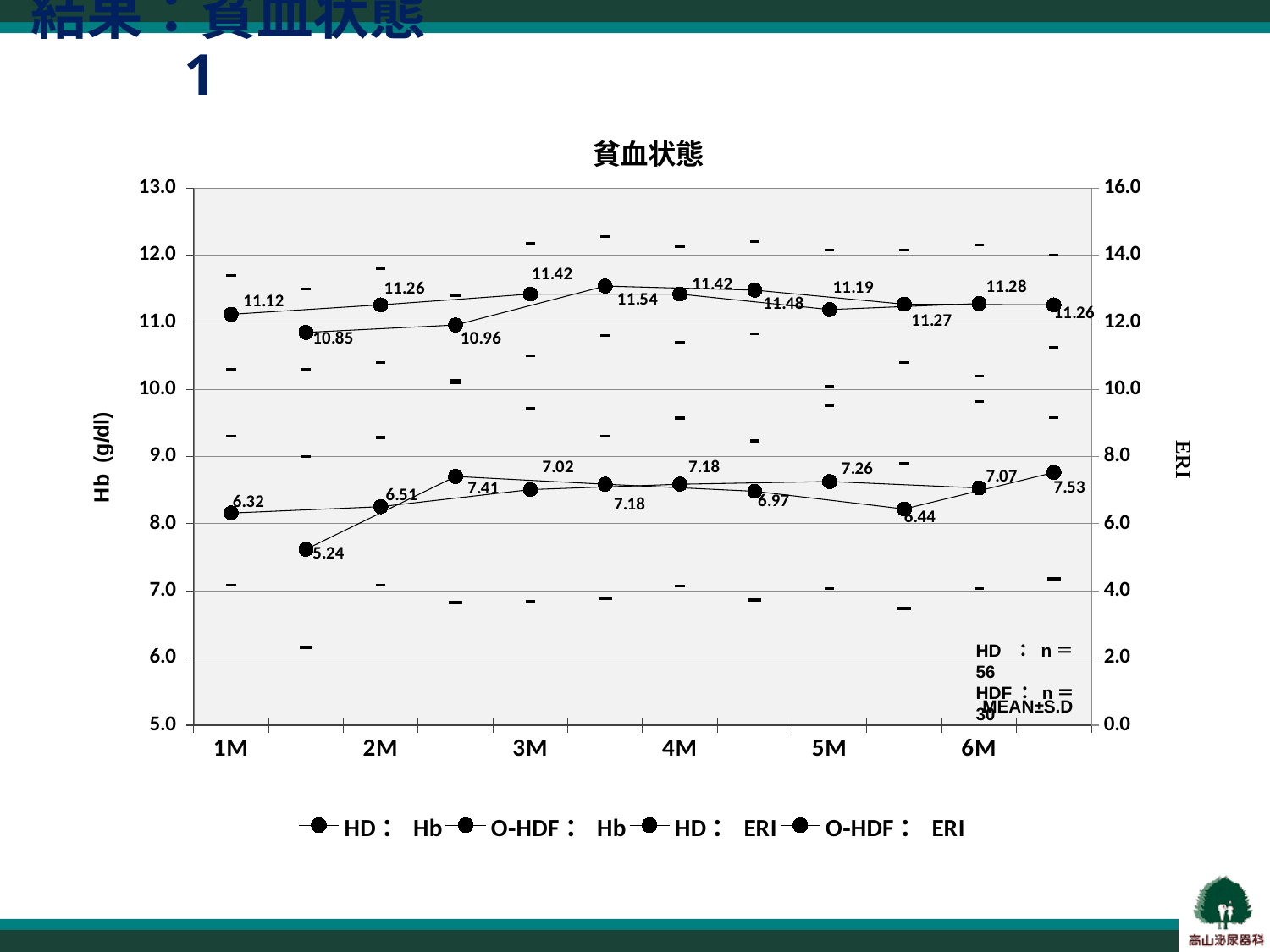
What is the title of the chart? 貧血状態 What is the lowest ERI value labelled on the chart? 5.24 How many month categories are shown on the x axis? 6 What is the label of the left vertical axis? Hb (g/dl) How many series does the chart legend list? 4 Which is larger, the ERI value labelled at 1M or the ERI value labelled at 6M? 6M What kind of chart is shown on the slide? line chart What is the difference between the Hb values labelled at 6M (11.28) and 1M (11.12)? 0.16 What ERI value is labelled at 1M on the lower line? 6.32 What is the highest Hb value labelled on the chart? 11.54 What Hb value is labelled at 1M on the upper line? 11.12 What Hb value is labelled at 6M on the upper line? 11.28